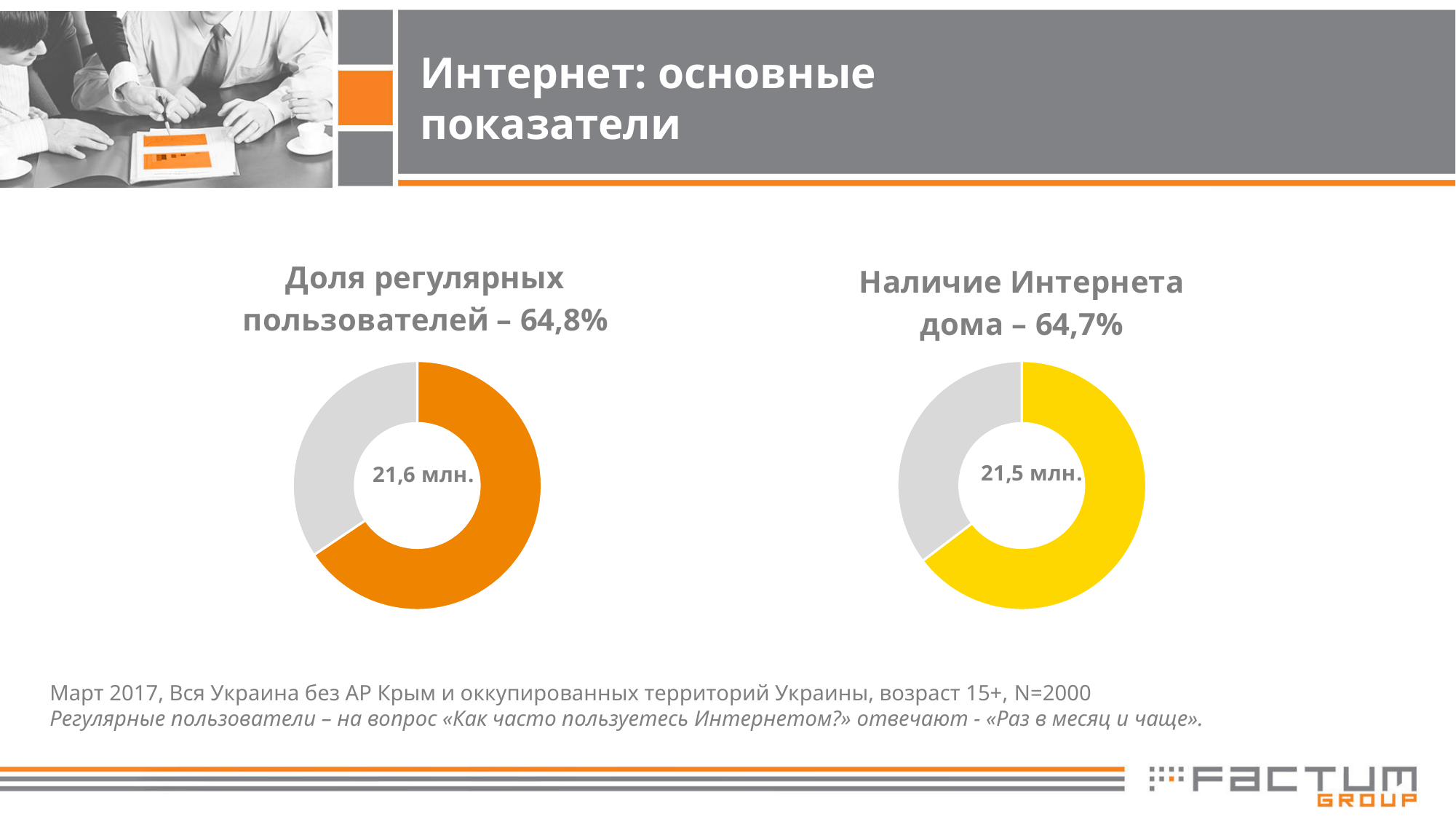
On the left chart, is the coloured (orange) slice greater or less than 50% of the donut? greater What colour is the highlighted slice on the right chart (Наличие Интернета дома)? Yellow How many slices does the right chart (Наличие Интернета дома) have? 2 On the right chart, what share of the donut is the grey slice? 35,3% On the left chart, what is the share of regular Internet users? 64,8% What colour is the highlighted slice on the left chart (Доля регулярных пользователей)? Orange What kind of chart is used on the left of the slide? Donut (pie) chart On the right chart, what is the share of households with Internet at home? 64,7% What is the difference in millions between the centre values of the left and right charts? 0,1 млн. What number is printed in the centre of the right chart (Наличие Интернета дома)? 21,5 млн. What number is printed in the centre of the left chart (Доля регулярных пользователей)? 21,6 млн. Which is larger: the share of regular users (left chart) or the share with Internet at home (right chart)? Share of regular users (64,8%)